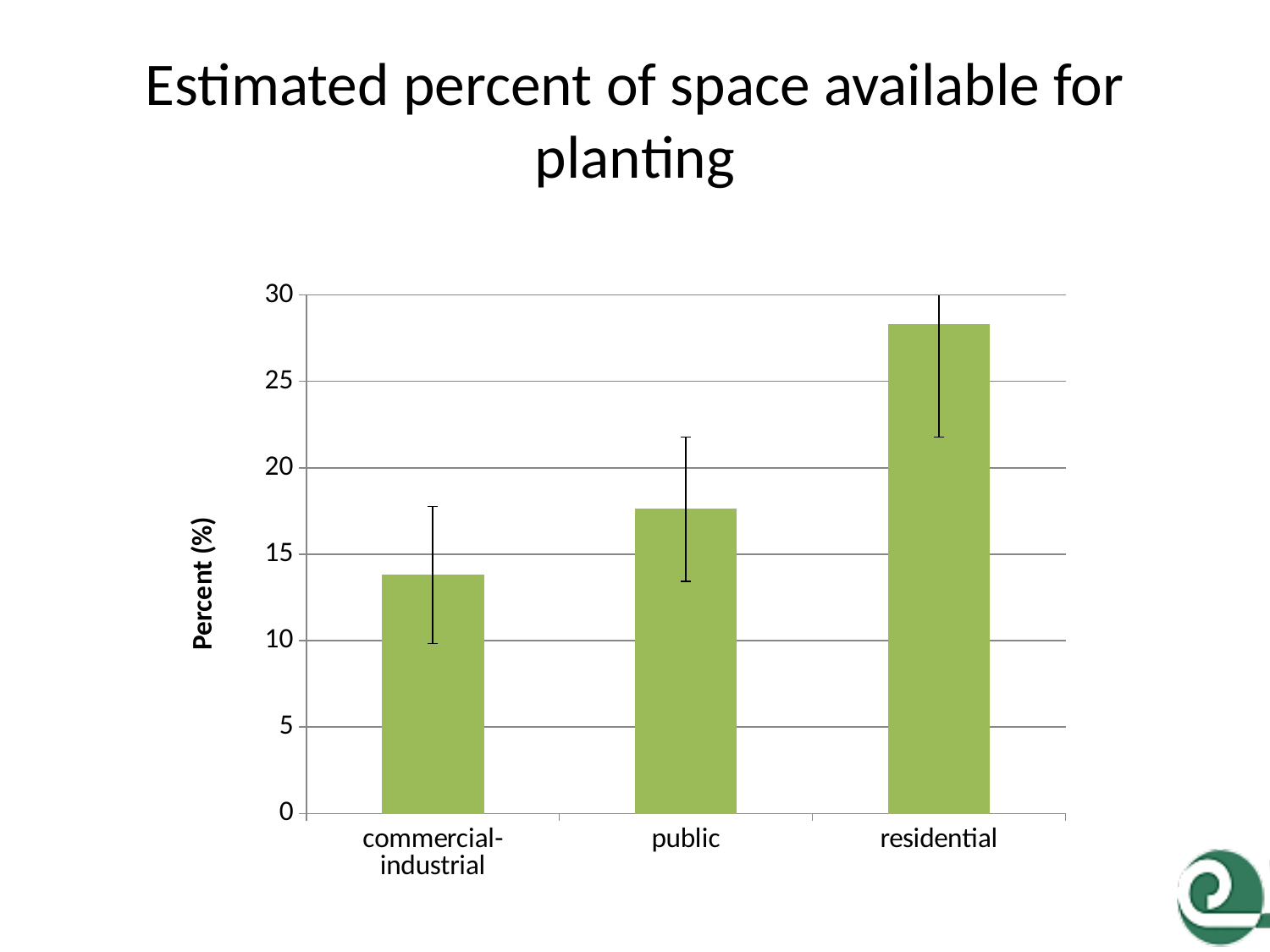
Which is larger, the value for residential or the value for public? residential Is the value for public greater or less than 15? greater Which category has the highest estimated percent of space available for planting? residential What is the label on the y axis? Percent (%) What is the title of the chart? Estimated percent of space available for planting Which is larger, the value for public or the value for commercial-industrial? public How many categories are plotted on the x axis? 3 Which category has the lowest estimated percent of space available for planting? commercial-industrial Is the value for commercial-industrial greater or less than 15? less Do the bar values rise or fall from left to right along the x axis? rise What kind of chart is shown on the slide? bar chart Is the value for residential greater or less than 25? greater